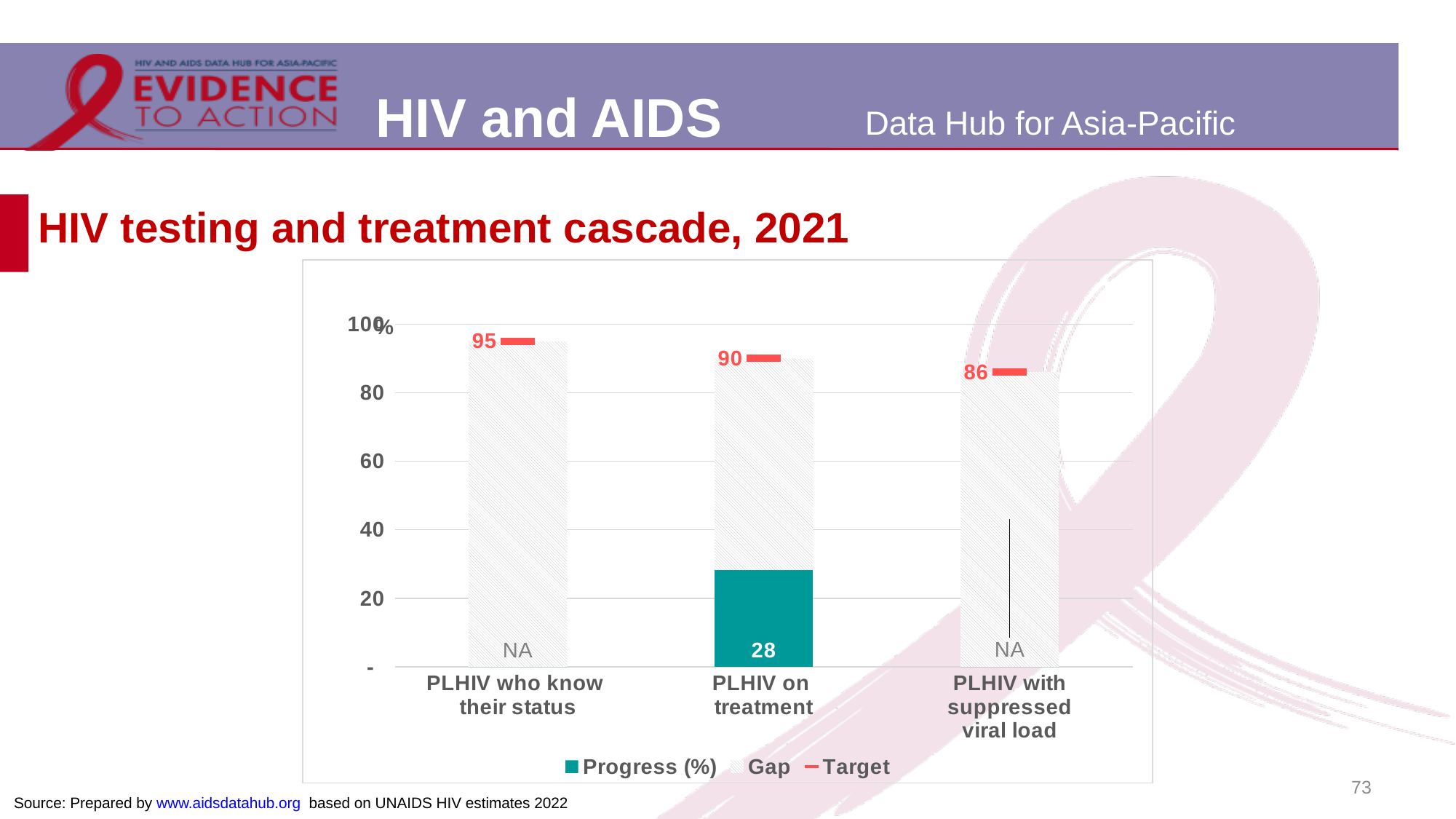
What is the Progress (%) value for PLHIV on treatment? 28 What is the difference between the Target values for PLHIV who know their status and PLHIV with suppressed viral load? 9 What is the Progress (%) value shown for PLHIV who know their status? NA What is the Progress (%) value shown for PLHIV with suppressed viral load? NA Which category has the highest Target value? PLHIV who know their status How many series does the legend list? 3 What is the Target value for PLHIV with suppressed viral load? 86 Is the Progress (%) value for PLHIV on treatment greater or less than 40? less What is the Target value for PLHIV on treatment? 90 What is the Target value for PLHIV who know their status? 95 How many categories are shown on the x axis? 3 Which category has the lowest Target value? PLHIV with suppressed viral load